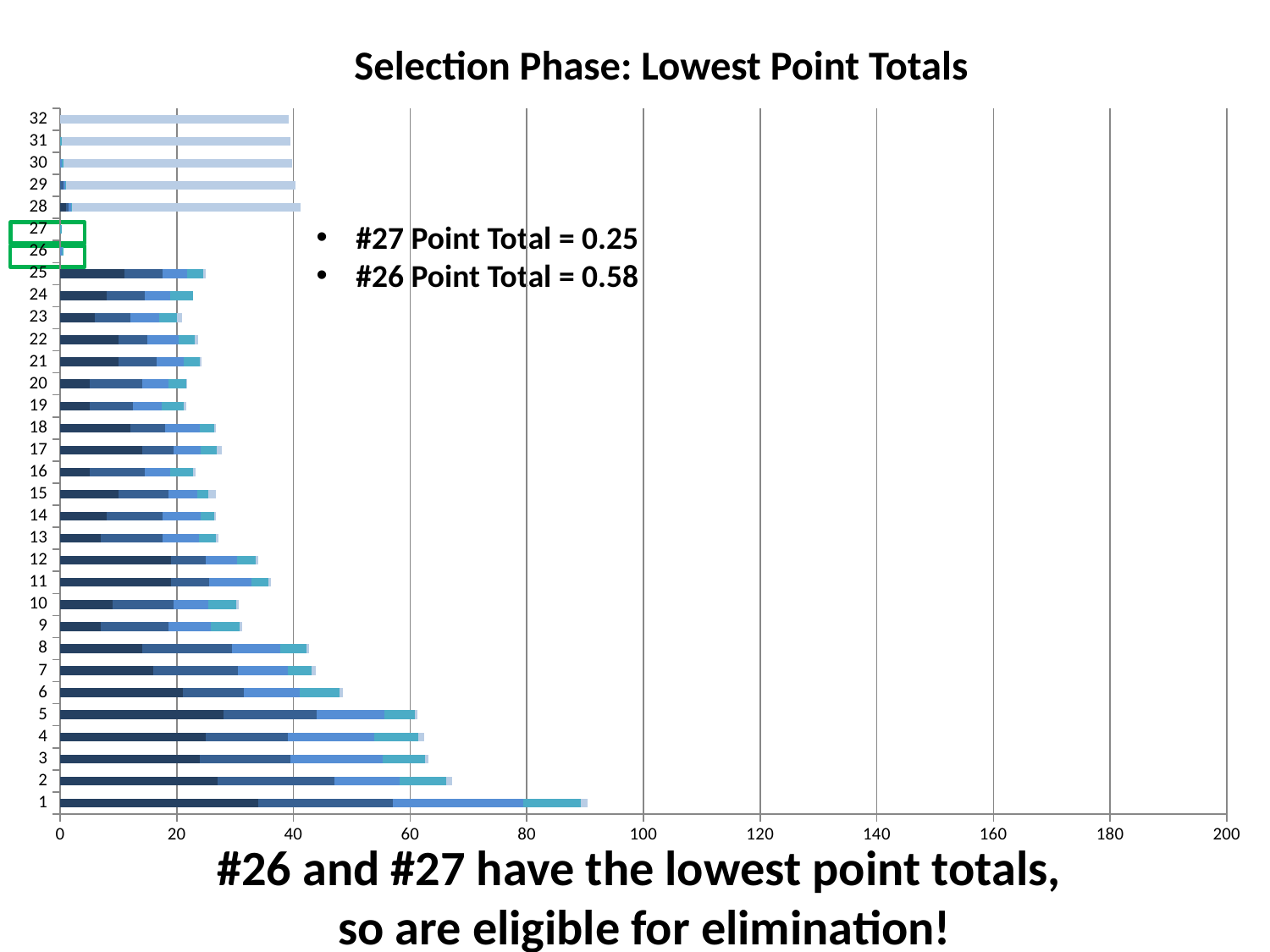
Which category has the highest point total in the chart? 1 What kind of chart is shown on the slide? bar chart Is the value for category 6 greater or less than 60? less What is the title of the chart? Selection Phase: Lowest Point Totals Which category has the lowest point total in the chart? 27 Is the value for category 1 greater or less than 80? greater What is the point total for #27 according to the slide? 0.25 What is the difference between the point totals of #26 and #27? 0.33 Which has the larger point total, #26 or #27? #26 Which categories are highlighted with green boxes on the chart? 26 and 27 How many categories are plotted on the vertical axis of the chart? 32 What is the point total for #26 according to the slide? 0.58